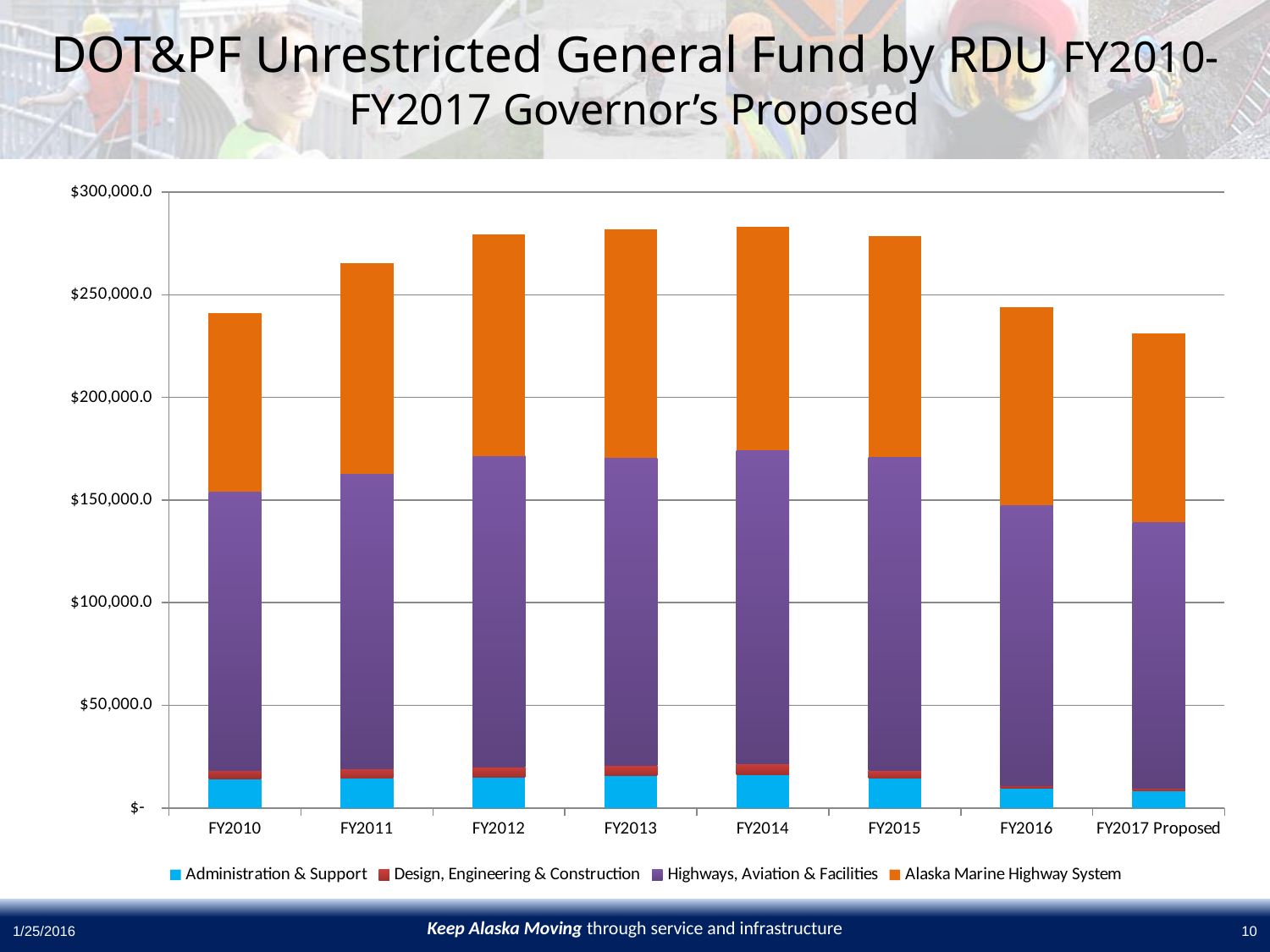
Do the total bars rise or fall from FY2014 to FY2017 Proposed? fall Which series forms the bottom segment of each stacked bar? Administration & Support Which series is shown in orange in the legend? Alaska Marine Highway System How many fiscal years (categories) are plotted on the x axis? 8 Is the total bar for FY2014 greater or less than $250,000.0? greater Which has the larger total bar, FY2010 or FY2011? FY2011 How many series does the legend list? 4 Which fiscal year has the lowest total bar? FY2017 Proposed What kind of chart is shown on the slide? Stacked bar chart Is the total bar for FY2017 Proposed greater or less than $250,000.0? less Is the total bar for FY2010 greater or less than $250,000.0? less Which has the larger total bar, FY2016 or FY2017 Proposed? FY2016